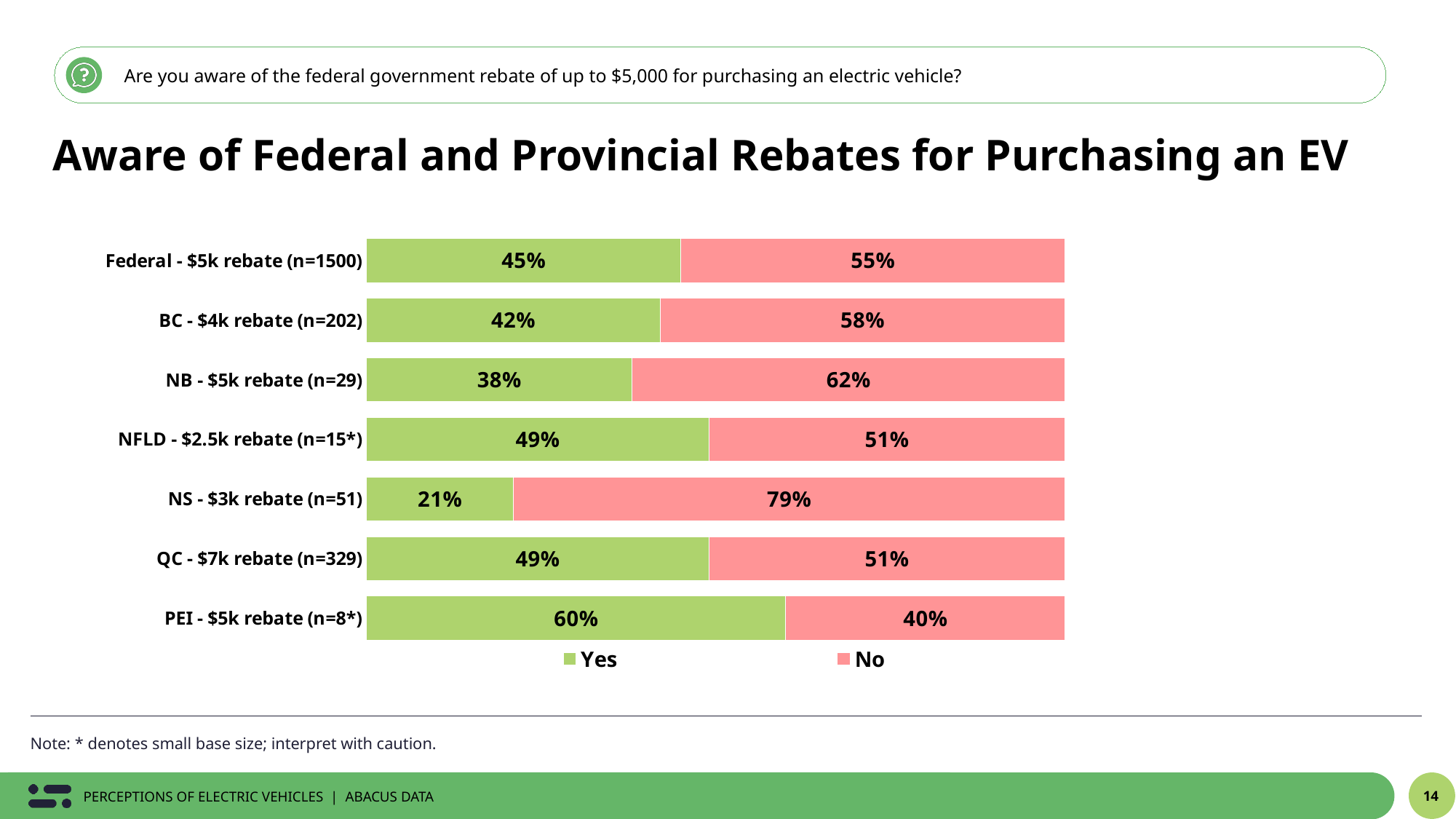
How many series does the legend list? 2 What is the difference between the No and Yes percentages for NB - $5k rebate (n=29)? 24% What is the Yes value for QC - $7k rebate (n=329)? 49% Which colour represents the No series in the chart? Red (pink) What kind of chart is shown on the slide? Stacked bar chart What is the total of the Yes and No segments for PEI - $5k rebate (n=8*)? 100% Which is larger: the Yes percentage for BC - $4k rebate (n=202) or the Yes percentage for NFLD - $2.5k rebate (n=15*)? NFLD - $2.5k rebate (n=15*) What percentage of respondents answered Yes for Federal - $5k rebate (n=1500)? 45% Which category has the lowest Yes percentage? NS - $3k rebate (n=51) How many categories are shown in the chart? 7 What percentage of respondents answered No for NS - $3k rebate (n=51)? 79% Which category has the highest Yes percentage? PEI - $5k rebate (n=8*)